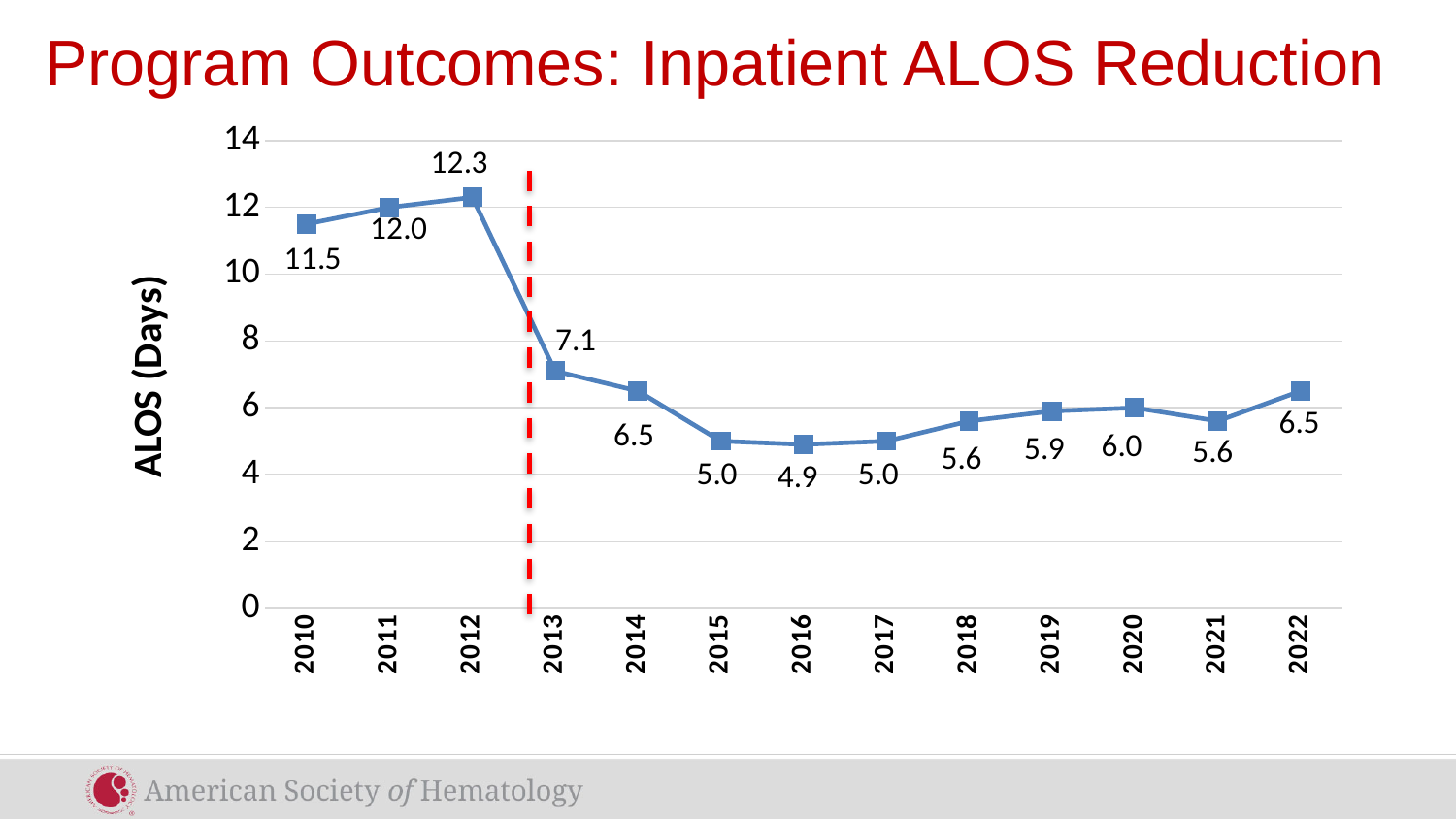
Does the ALOS rise or fall from 2012 to 2015? Fall What is the label of the y axis? ALOS (Days) How many years are plotted on the x axis? 13 What kind of chart is shown on the slide? Line chart Which year has the lowest ALOS? 2016 Which year has a higher ALOS, 2010 or 2014? 2010 Which year has the highest ALOS? 2012 Is the ALOS value for 2011 greater or less than 10? greater What is the ALOS value for 2022? 6.5 What is the ALOS value for 2016? 4.9 What is the ALOS value for 2012? 12.3 What is the difference in ALOS between 2012 and 2013? 5.2